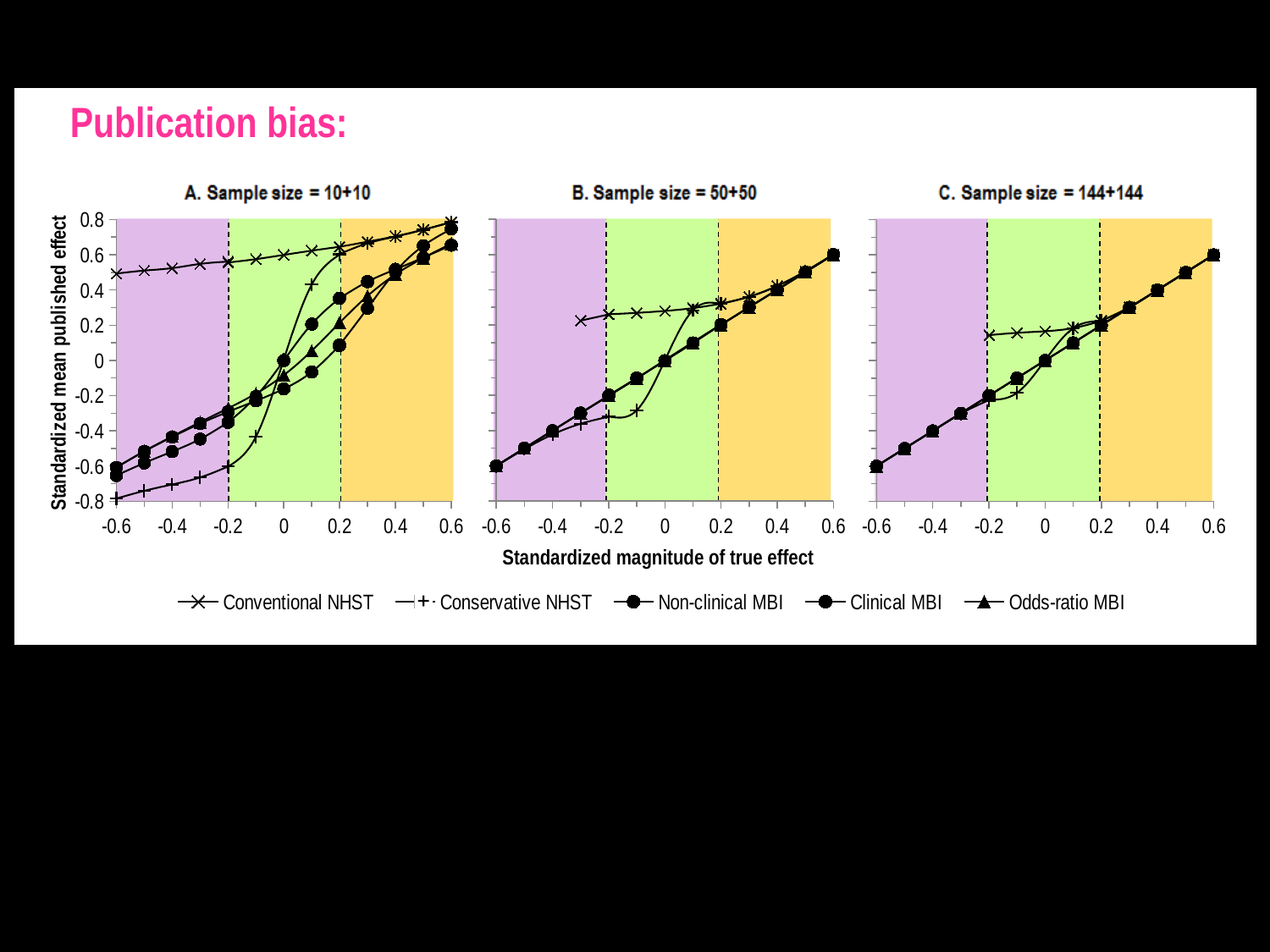
In panel C (Sample size = 144+144), does the Clinical MBI line rise or fall as the true effect increases from -0.6 to 0.6? Rises In panel B (Sample size = 50+50), is the value for Conventional NHST at a true effect of -0.2 greater or less than 0? greater How many series does the shared legend list for the charts? 5 What is the title of the third (rightmost) chart panel? C. Sample size = 144+144 In panel A (Sample size = 10+10), is the value for Conservative NHST at a true effect of -0.6 greater or less than -0.6? less What kind of chart is shown in panel A (Sample size = 10+10)? Line chart How many chart panels are shown on the slide? 3 In panel A (Sample size = 10+10), is the value for Conventional NHST at a true effect of -0.6 greater or less than 0.4? greater In panel A (Sample size = 10+10), does the Conventional NHST line rise or fall as the true effect increases from -0.6 to 0.6? Rises What is the label on the shared x axis of the charts? Standardized magnitude of true effect In panel A (Sample size = 10+10), at a true effect of -0.6, which is larger: Conventional NHST or Conservative NHST? Conventional NHST